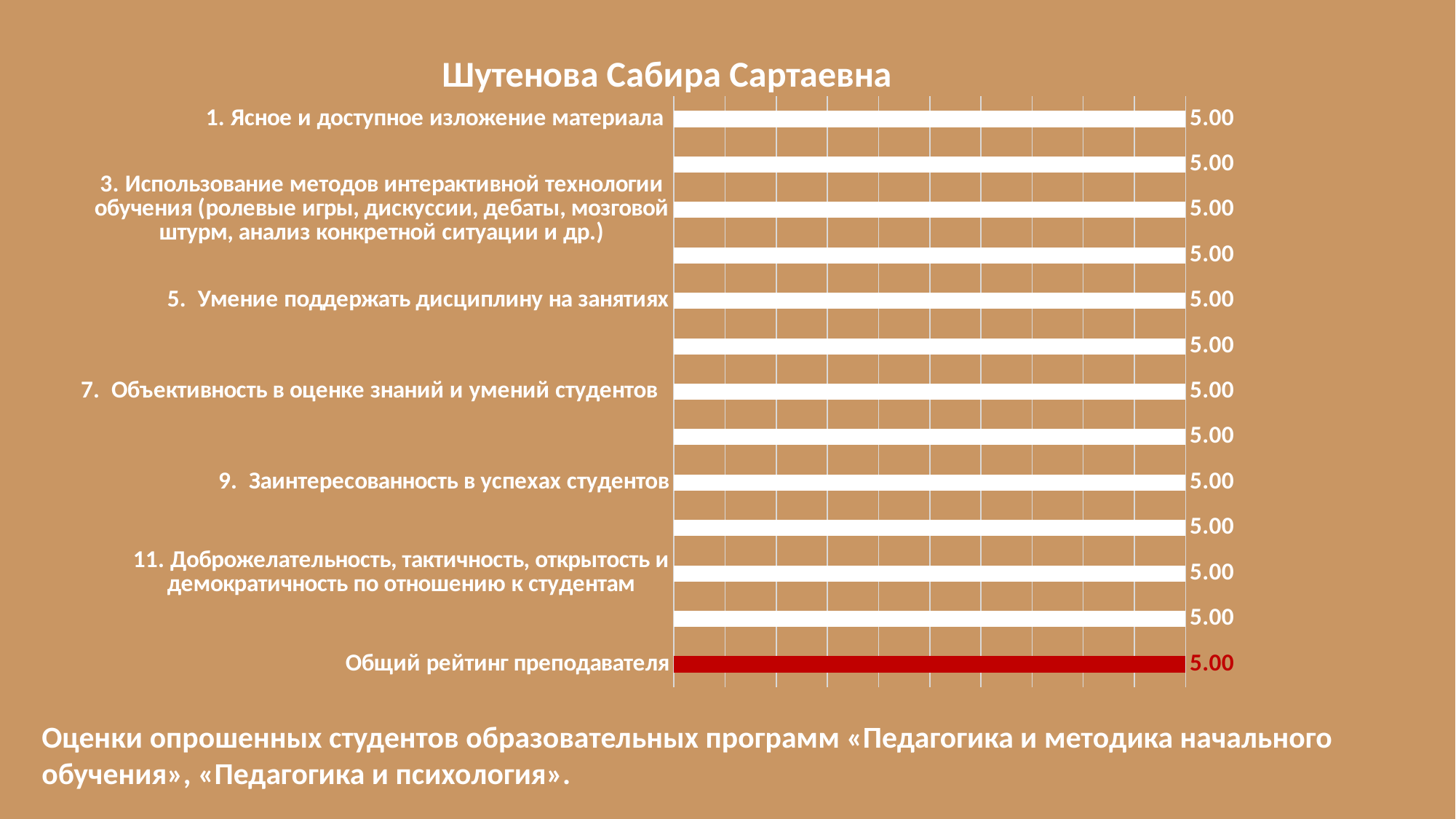
How many bars are plotted in the chart? 13 What is the value for "5. Умение поддержать дисциплину на занятиях"? 5.00 What is the value for "7. Объективность в оценке знаний и умений студентов"? 5.00 What is the value for "9. Заинтересованность в успехах студентов"? 5.00 Is the value for "9. Заинтересованность в успехах студентов" larger than, smaller than, or equal to the value for "5. Умение поддержать дисциплину на занятиях"? equal What is the difference between the value for "1. Ясное и доступное изложение материала" and the value for "Общий рейтинг преподавателя"? 0.00 What is the value for "1. Ясное и доступное изложение материала"? 5.00 What is the title of the chart? Шутенова Сабира Сартаевна What is the value for "Общий рейтинг преподавателя"? 5.00 What is the value for "11. Доброжелательность, тактичность, открытость и демократичность по отношению к студентам"? 5.00 What kind of chart is shown on the slide? bar chart What colour is the bar for "Общий рейтинг преподавателя"? red